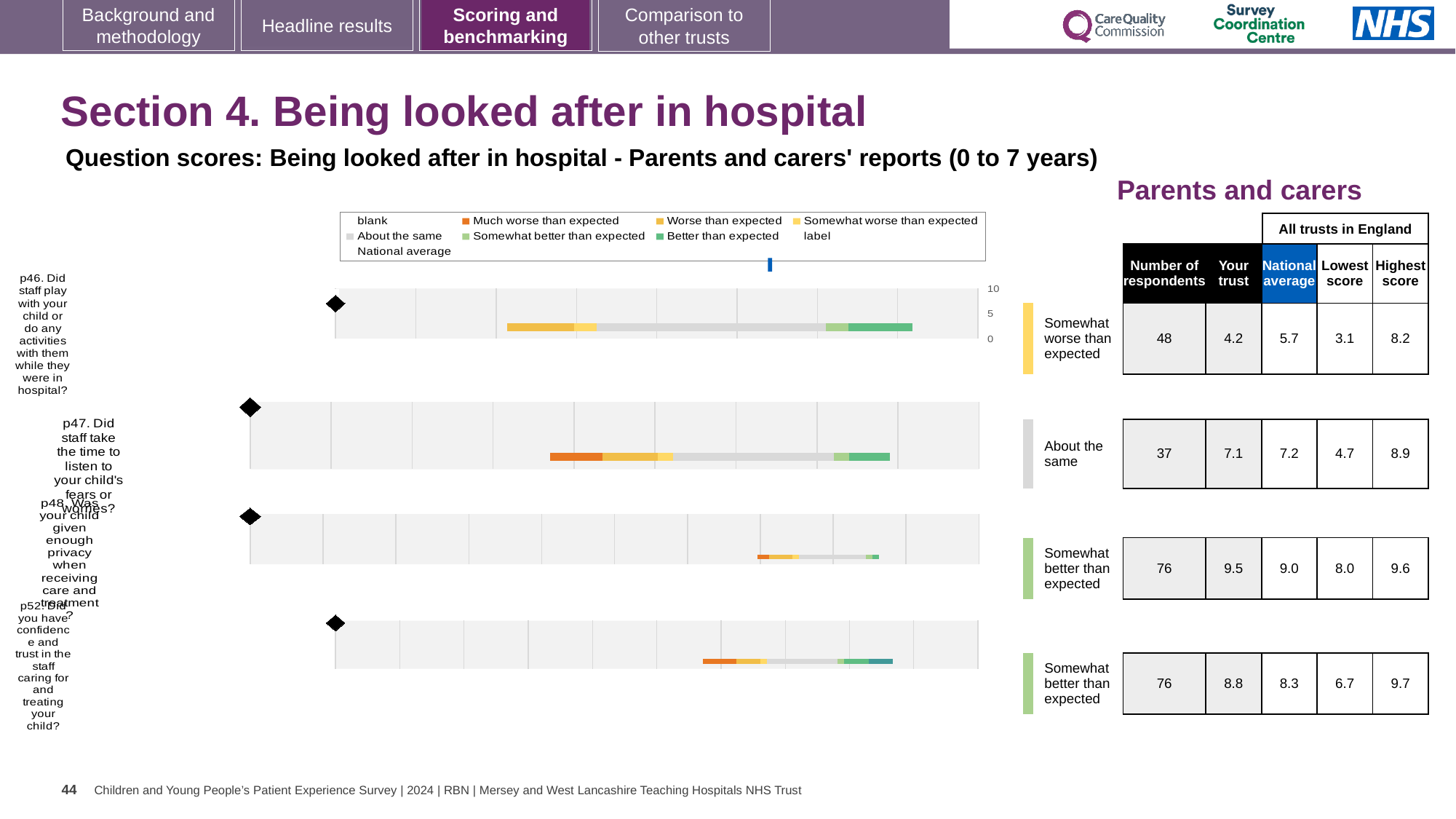
What is the maximum value shown on the score axis of the charts? 10 Which question has the lowest 'Your trust' score on this slide? p46 What is the highest score across all trusts in England for p52 (Did you have confidence and trust in the staff caring for and treating your child?)? 9.7 How many survey questions (p46, p47, p48, p52) have a chart on this slide? 4 What benchmark category is shown for p46? Somewhat worse than expected How many respondents answered p48 (Was your child given enough privacy when receiving care and treatment?)? 76 What is the difference between the national average and the 'Your trust' score for p46? 1.5 For p47, which is larger: the 'Your trust' score or the national average? National average Which question has the highest 'Your trust' score on this slide? p48 What is the national average score for p47 (Did staff take the time to listen to your child's fears or worries?)? 7.2 What is the 'Your trust' score for p46 (Did staff play with your child or do any activities with them while they were in hospital?)? 4.2 What kind of chart is used to show the question scores on this slide? Bar chart